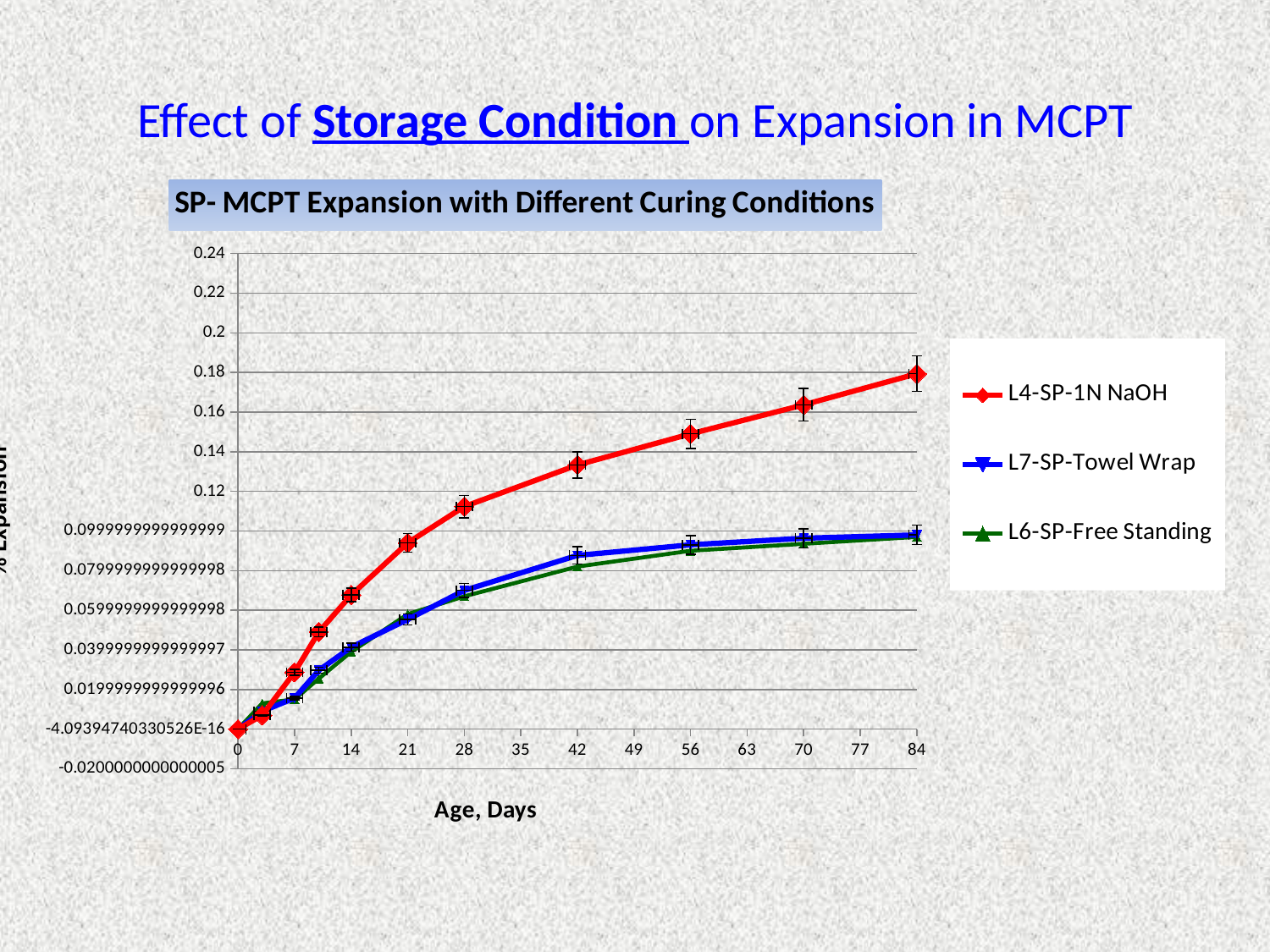
Is the value for L4-SP-1N NaOH at 42 days greater or less than 0.12? greater What kind of chart is shown on the slide? line chart How many series does the legend list? 3 What is the title of the chart? SP- MCPT Expansion with Different Curing Conditions Which series has the highest expansion at 84 days? L4-SP-1N NaOH At 14 days, which is larger: L4-SP-1N NaOH or L6-SP-Free Standing? L4-SP-1N NaOH Do the values for L4-SP-1N NaOH rise or fall as age increases? rise Is the value for L4-SP-1N NaOH at 56 days greater or less than 0.14? greater At 84 days, which is larger: L4-SP-1N NaOH or L7-SP-Towel Wrap? L4-SP-1N NaOH Is the value for L7-SP-Towel Wrap at 84 days greater or less than 0.12? less What is the label of the x axis? Age, Days